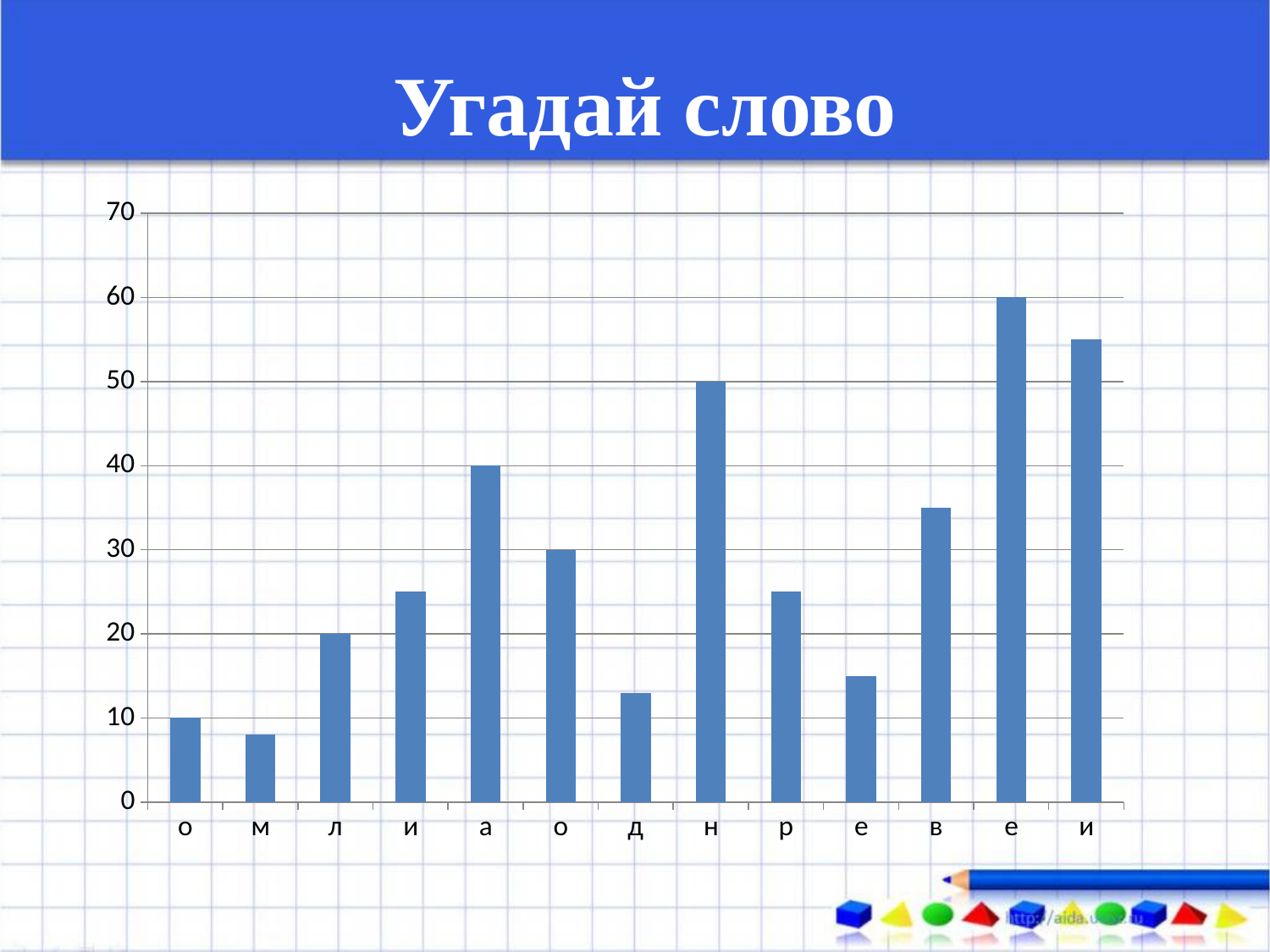
Is the value for "м" greater or less than 10? less Is the value for "в" greater or less than 30? greater What is the value of the bar for "а"? 40 Which bar is the tallest in the chart? the second "е" (twelfth bar from the left) How many bars (categories) are plotted in the chart? 13 What is the title of the slide? Угадай слово Which bar is the shortest in the chart? м What is the value of the first bar from the left, labelled "о"? 10 What kind of chart is shown on the slide? bar chart What is the value of the bar for "л"? 20 What is the difference between the values for "н" and "л"? 30 What is the value of the bar for "н"? 50